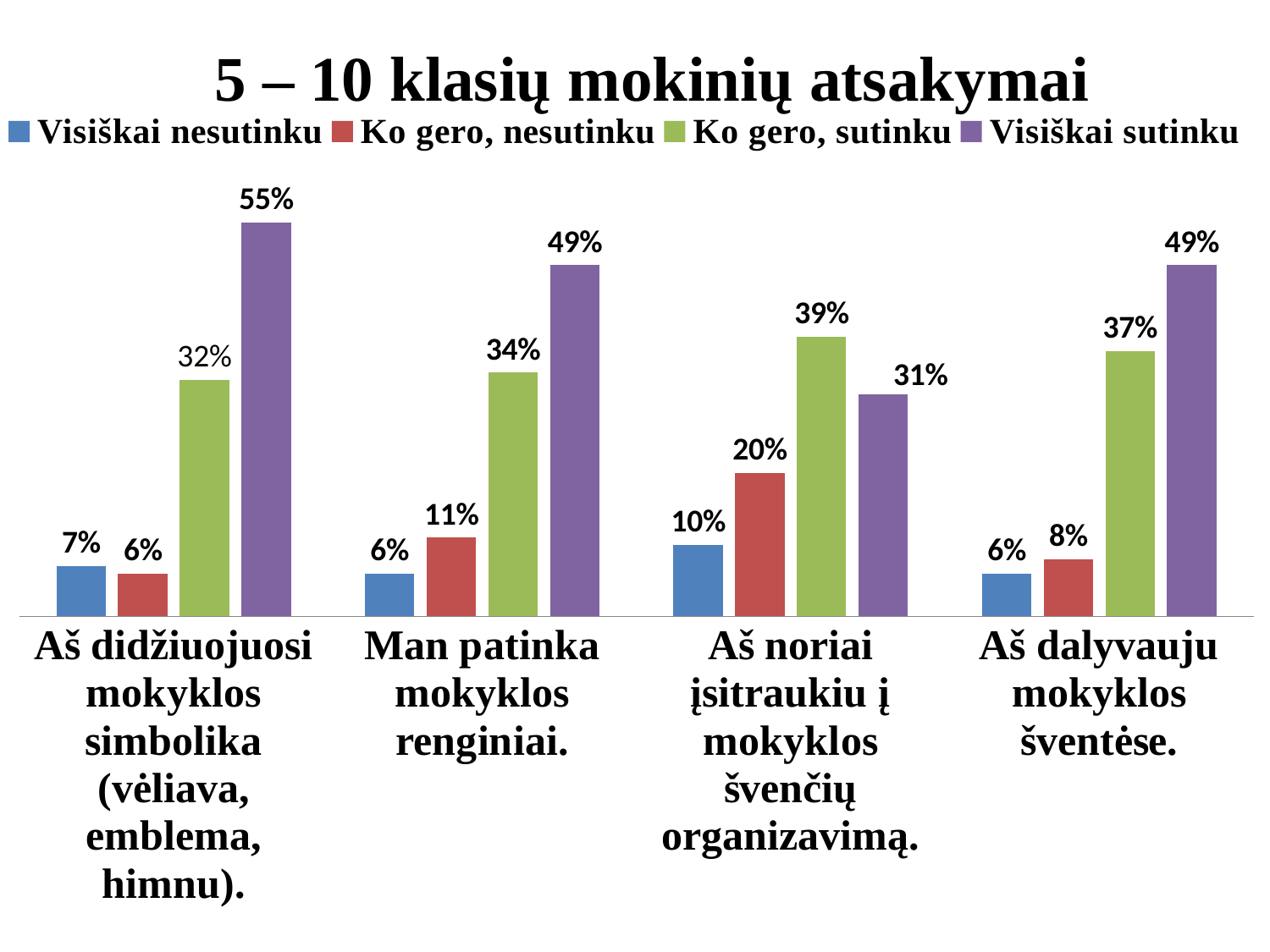
How many series does the legend list? 4 What is the value for "Ko gero, nesutinku" in the category "Aš noriai įsitraukiu į mokyklos švenčių organizavimą."? 20% What kind of chart is shown on the slide? Bar chart How many categories are shown on the x axis? 4 What is the title of the chart? 5 – 10 klasių mokinių atsakymai Which series is shown in purple in the legend? Visiškai sutinku What is the value for "Ko gero, sutinku" in the category "Aš dalyvauju mokyklos šventėse."? 37% What is the value for "Visiškai sutinku" in the category "Aš didžiuojuosi mokyklos simbolika (vėliava, emblema, himnu)."? 55% In the category "Aš noriai įsitraukiu į mokyklos švenčių organizavimą.", which is larger: "Ko gero, sutinku" or "Visiškai sutinku"? Ko gero, sutinku What is the difference between "Visiškai sutinku" and "Ko gero, sutinku" in the category "Man patinka mokyklos renginiai."? 15% Which category has the highest value for "Visiškai sutinku"? Aš didžiuojuosi mokyklos simbolika (vėliava, emblema, himnu). Which category has the lowest value for "Visiškai sutinku"? Aš noriai įsitraukiu į mokyklos švenčių organizavimą.